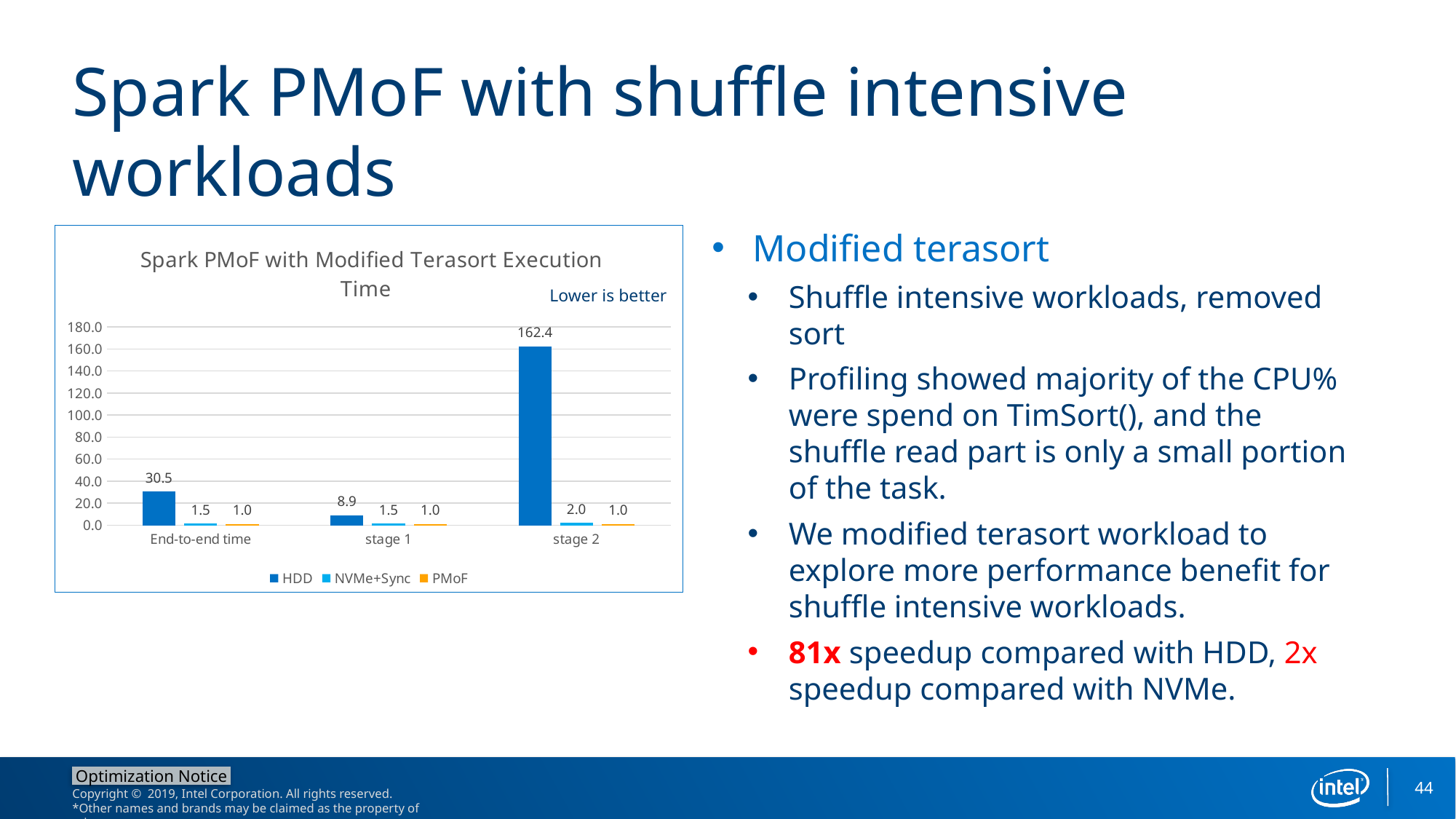
What kind of chart is shown on the slide? bar chart Which is larger for stage 2: the NVMe+Sync value or the PMoF value? NVMe+Sync Which category has the highest HDD value? stage 2 What is the HDD value for End-to-end time? 30.5 What is the PMoF value for stage 1? 1.0 Which category has the lowest HDD value? stage 1 How many categories are shown on the x axis? 3 What is the HDD value for stage 2? 162.4 Is the HDD value for stage 2 greater or less than 160.0? greater What is the difference between the HDD and NVMe+Sync values for End-to-end time? 29.0 How many series does the legend list? 3 What is the NVMe+Sync value for stage 2? 2.0